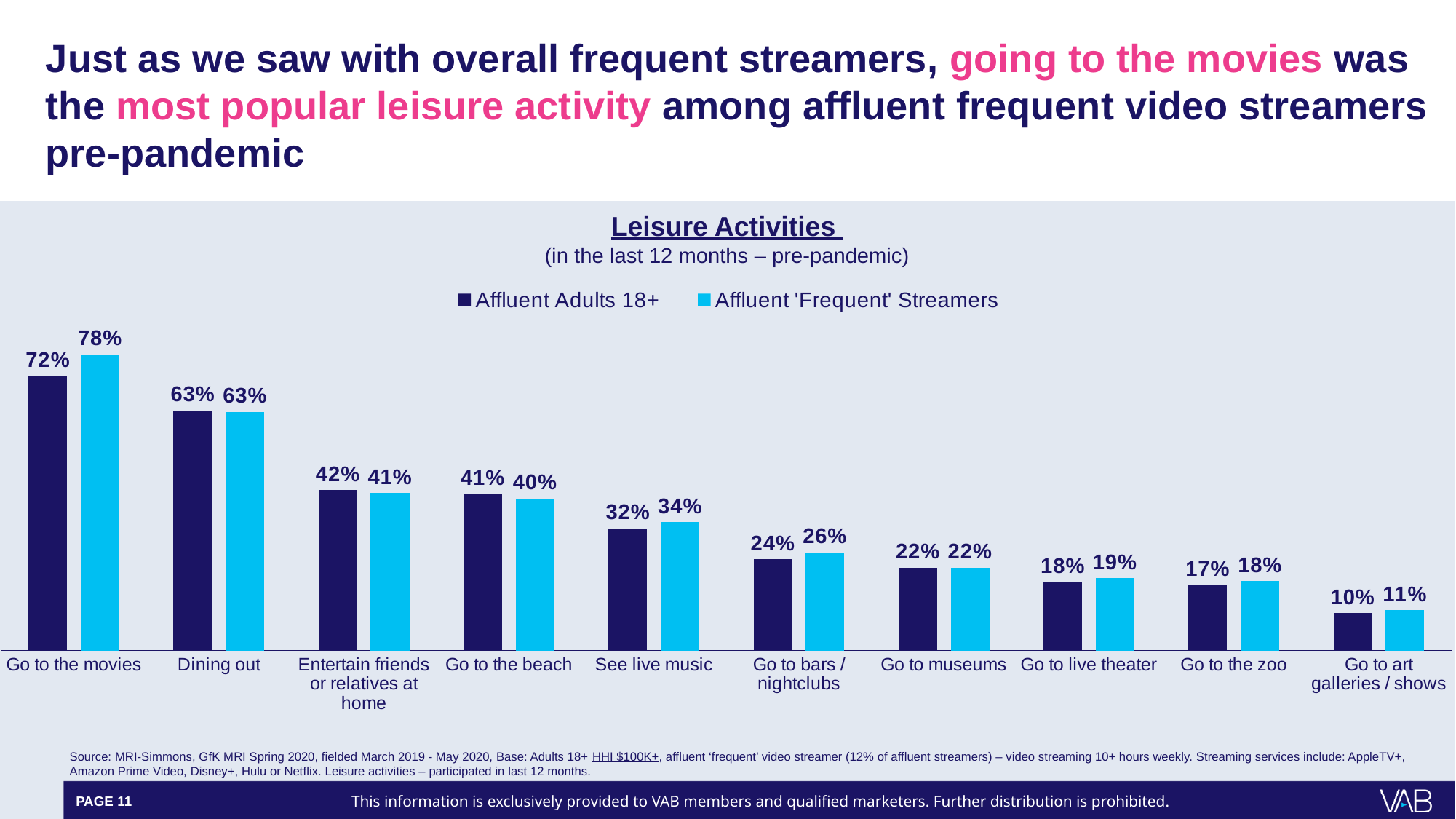
How many series does the legend list? 2 Which leisure activity has the lowest value for Affluent Adults 18+? Go to art galleries / shows Do the values for Affluent Adults 18+ rise or fall from left to right across the activities? Fall What is the difference between Affluent 'Frequent' Streamers and Affluent Adults 18+ for Go to the movies? 6% What is the title of the chart? Leisure Activities What percentage of Affluent 'Frequent' Streamers went to bars / nightclubs? 26% How many leisure activities are shown on the chart? 10 Which leisure activity has the highest value for Affluent 'Frequent' Streamers? Go to the movies What is the value for Affluent Adults 18+ for Dining out? 63% Which is larger for See live music: Affluent Adults 18+ or Affluent 'Frequent' Streamers? Affluent 'Frequent' Streamers What percentage of Affluent 'Frequent' Streamers went to the movies? 78% What kind of chart is shown on the slide? Bar chart